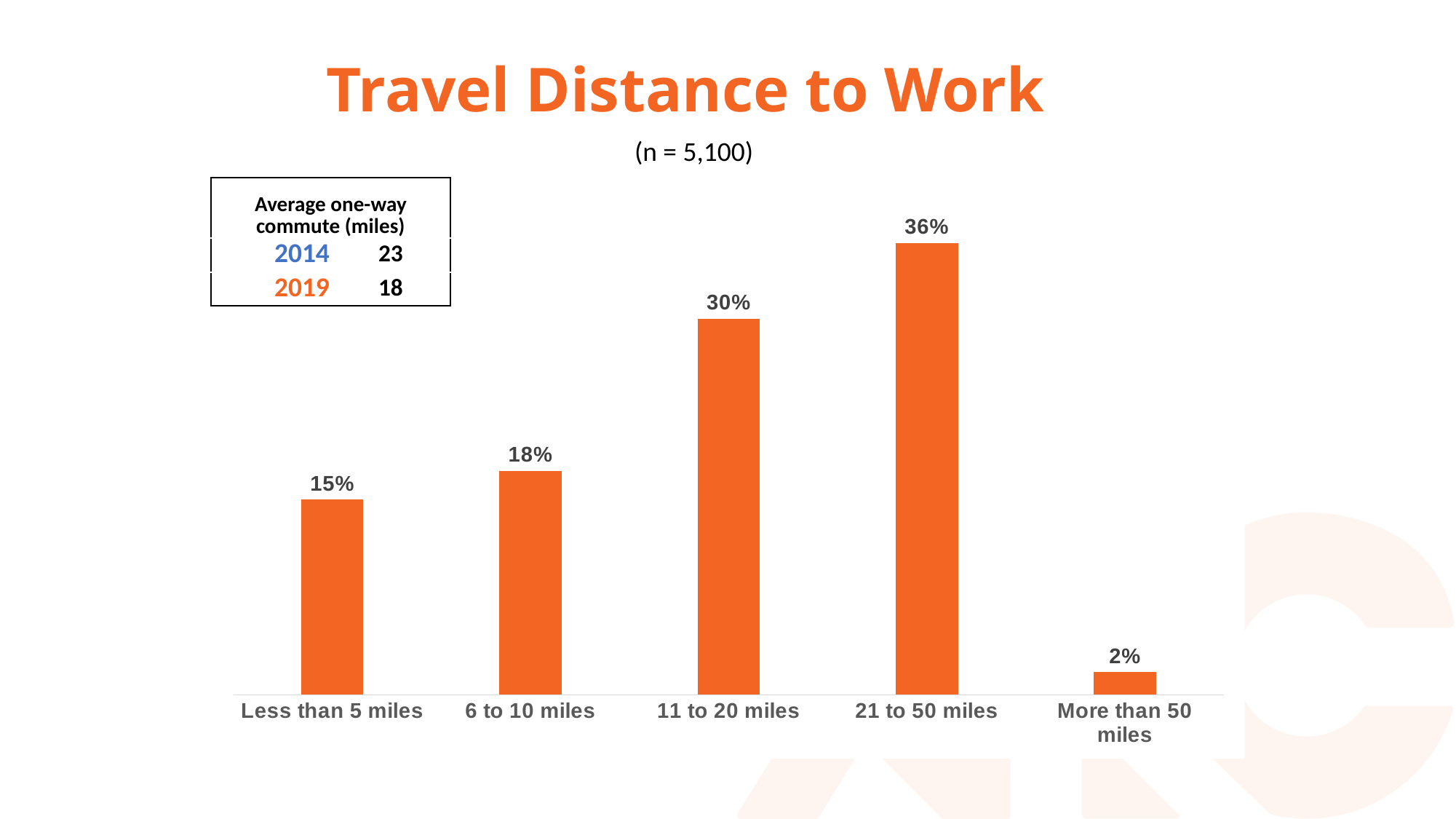
What is the sample size (n) shown under the chart title? 5,100 What is the difference between the 6 to 10 miles and Less than 5 miles values? 3% Which travel distance category has the highest percentage? 21 to 50 miles What is the value for the More than 50 miles category? 2% What kind of chart is shown on the slide? Bar chart What percentage of respondents travel less than 5 miles to work? 15% What is the difference between the 21 to 50 miles and 11 to 20 miles values? 6% What is the value for the 6 to 10 miles category? 18% Which travel distance category has the lowest percentage? More than 50 miles How many travel distance categories are shown in the chart? 5 Which is larger, the value for 11 to 20 miles or the value for 6 to 10 miles? 11 to 20 miles What percentage of respondents travel 11 to 20 miles to work? 30%